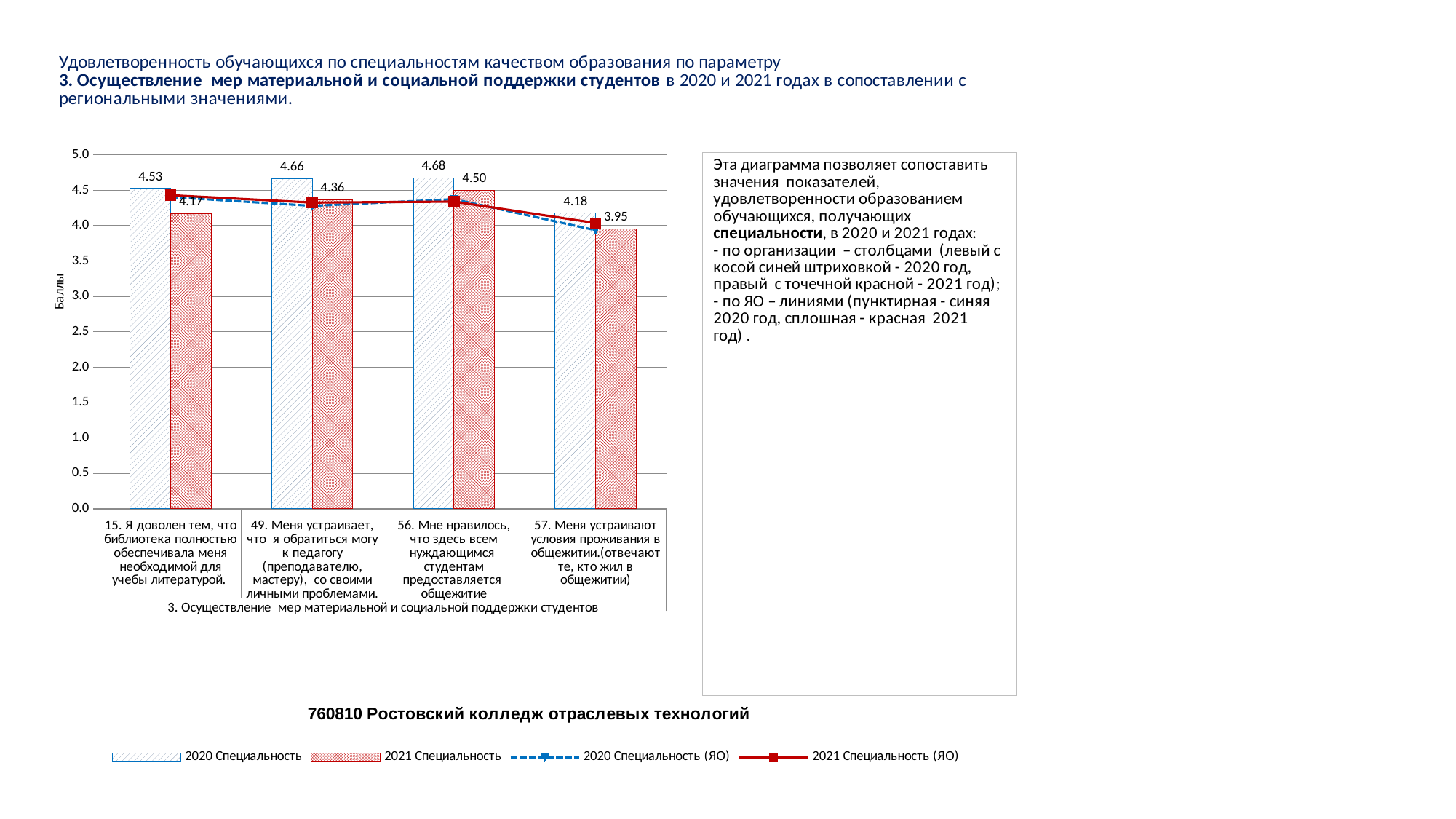
How many series does the legend list? 4 What is the difference between the 2020 and 2021 Специальность values for item 56? 0.18 What is the label of the vertical axis? Баллы Which item has the highest 2020 Специальность value? 56. Мне нравилось, что здесь всем нуждающимся студентам предоставляется общежитие What is the 2021 Специальность value for item 57 (Меня устраивают условия проживания в общежитии)? 3.95 Which is larger for item 49: the 2020 Специальность value or the 2021 Специальность value? 2020 Специальность What is the 2020 Специальность value for item 15 (Я доволен тем, что библиотека полностью обеспечивала меня необходимой для учебы литературой)? 4.53 What is the 2021 Специальность value for item 49 (Меня устраивает, что я обратиться могу к педагогу)? 4.36 Is the 2021 Специальность value for item 57 greater or less than 4.0? less Which item has the lowest 2021 Специальность value? 57. Меня устраивают условия проживания в общежитии What is the difference between the 2020 and 2021 Специальность values for item 15? 0.36 How many items (categories) are shown on the x axis? 4